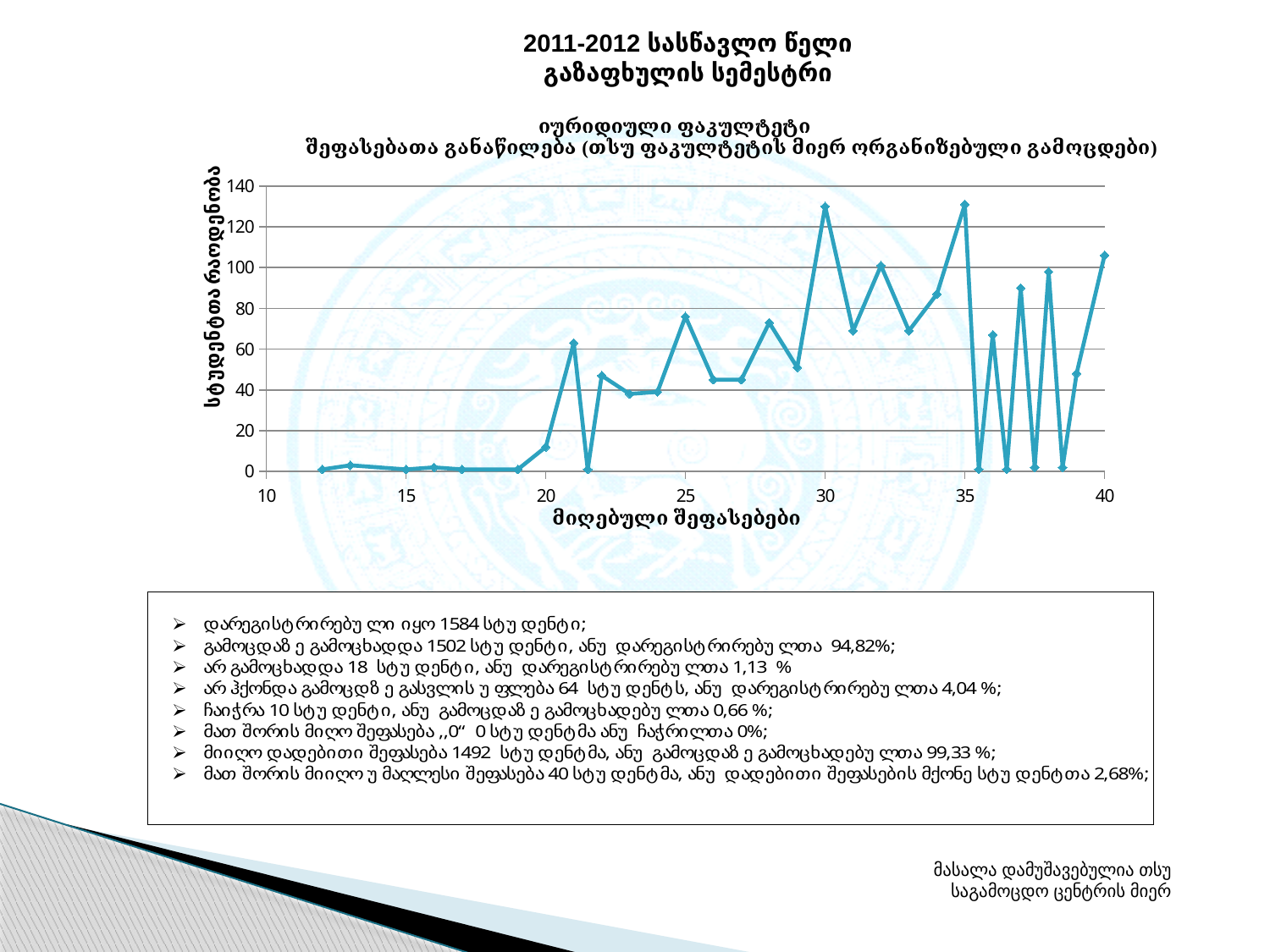
Between scores 10 and 19, do the values rise, fall, or stay roughly flat? stay roughly flat Which has the larger value, score 25 or score 22? score 25 Is the value for score 15 greater or less than 20? less Is the value for score 30 greater or less than 120? greater Is the value for score 35 greater or less than 120? greater What is the title of the x axis of the chart? მიღებული შეფასებები What kind of chart is shown on the slide? line chart What is the title of the y axis of the chart? სტუდენტთა რაოდენობა Which has the larger value, score 30 or score 20? score 30